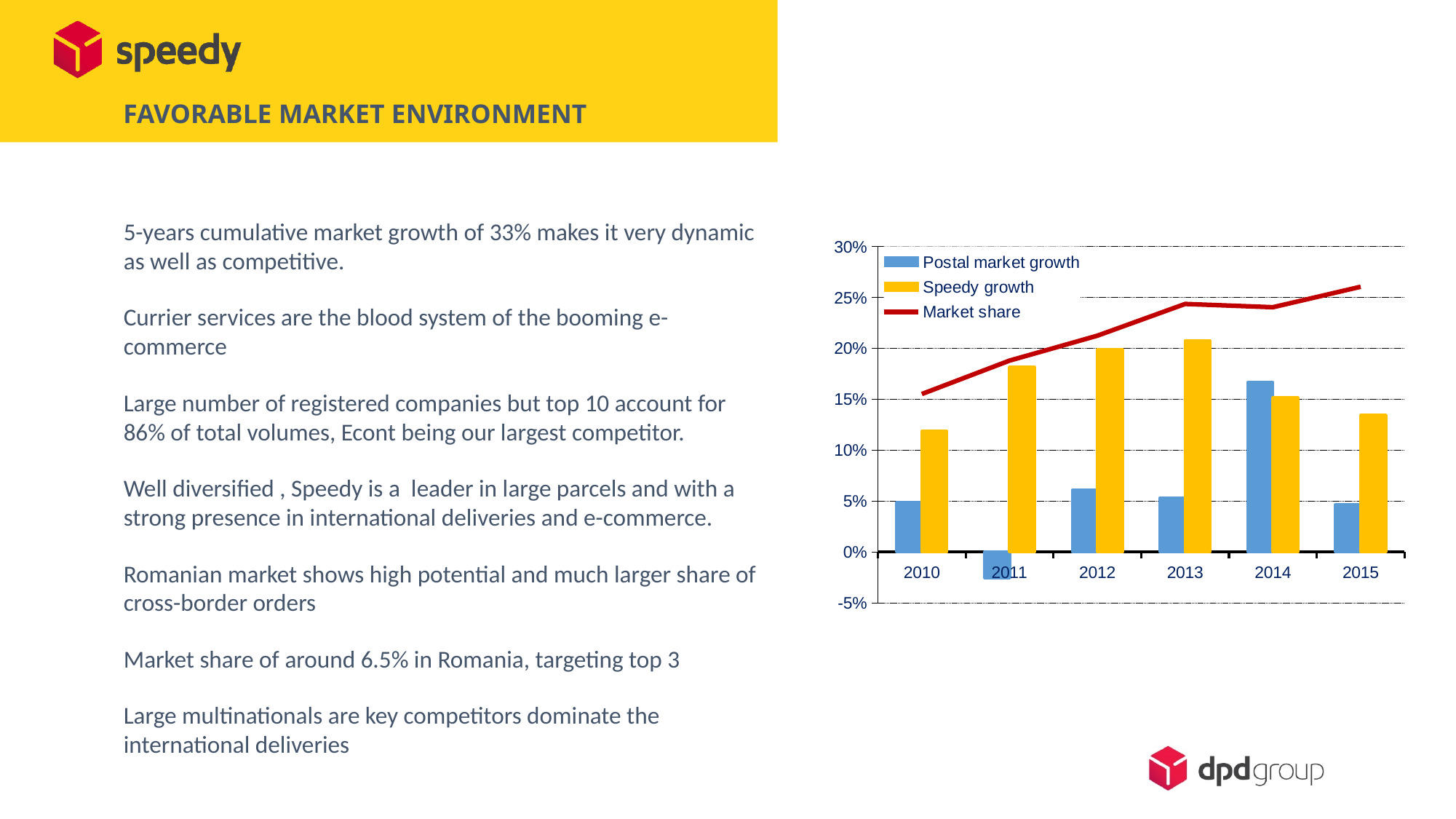
Is the value for Postal market growth in 2014 greater or less than 15%? greater In which year is Market share highest? 2015 Is the value for Postal market growth in 2011 greater or less than 0%? less In which year is Speedy growth lowest? 2010 In which year is Postal market growth lowest? 2011 What kind of chart is shown on the slide? A combined bar and line chart Does Market share generally rise or fall from 2010 to 2015? rise In which year is Postal market growth highest? 2014 How many series does the chart legend list? 3 How many years are shown on the x axis of the chart? 6 Is the value for Market share in 2015 greater or less than 25%? greater Which series is drawn as a line in the chart? Market share